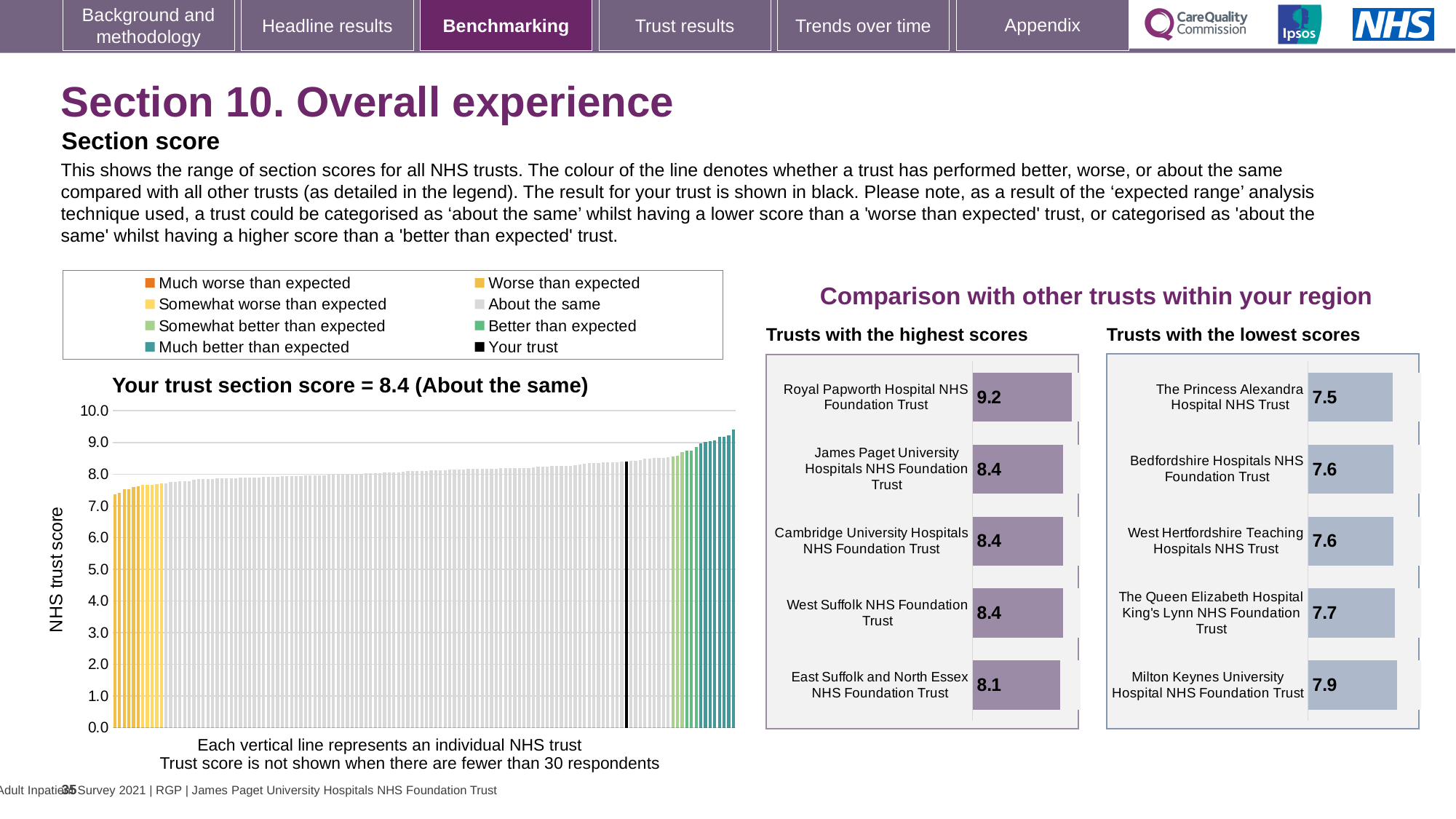
In the 'Your trust section score' chart, do the trust scores rise or fall from left to right? rise In the 'Trusts with the lowest scores' chart, which has the larger score: Bedfordshire Hospitals NHS Foundation Trust or The Queen Elizabeth Hospital King's Lynn NHS Foundation Trust? The Queen Elizabeth Hospital King's Lynn NHS Foundation Trust In the 'Your trust section score' chart, what kind of chart is shown? bar chart In the 'Trusts with the highest scores' chart, what is the score for Royal Papworth Hospital NHS Foundation Trust? 9.2 How many entries does the legend above the 'Your trust section score' chart list? 8 In the 'Your trust section score' chart, is the value of the leftmost (lowest) bar greater or less than 7.0? greater In the 'Trusts with the highest scores' chart, what is the difference between the scores of Royal Papworth Hospital NHS Foundation Trust and East Suffolk and North Essex NHS Foundation Trust? 1.1 In the 'Your trust section score' chart, what is the section score for your trust? 8.4 In the 'Your trust section score' chart, is the value of the rightmost (highest) bar greater or less than 10.0? less In the 'Your trust section score' chart, what is the label on the vertical axis? NHS trust score In the 'Trusts with the highest scores' chart, which trust has the lowest score? East Suffolk and North Essex NHS Foundation Trust In the 'Trusts with the lowest scores' chart, which trust has the highest score? Milton Keynes University Hospital NHS Foundation Trust